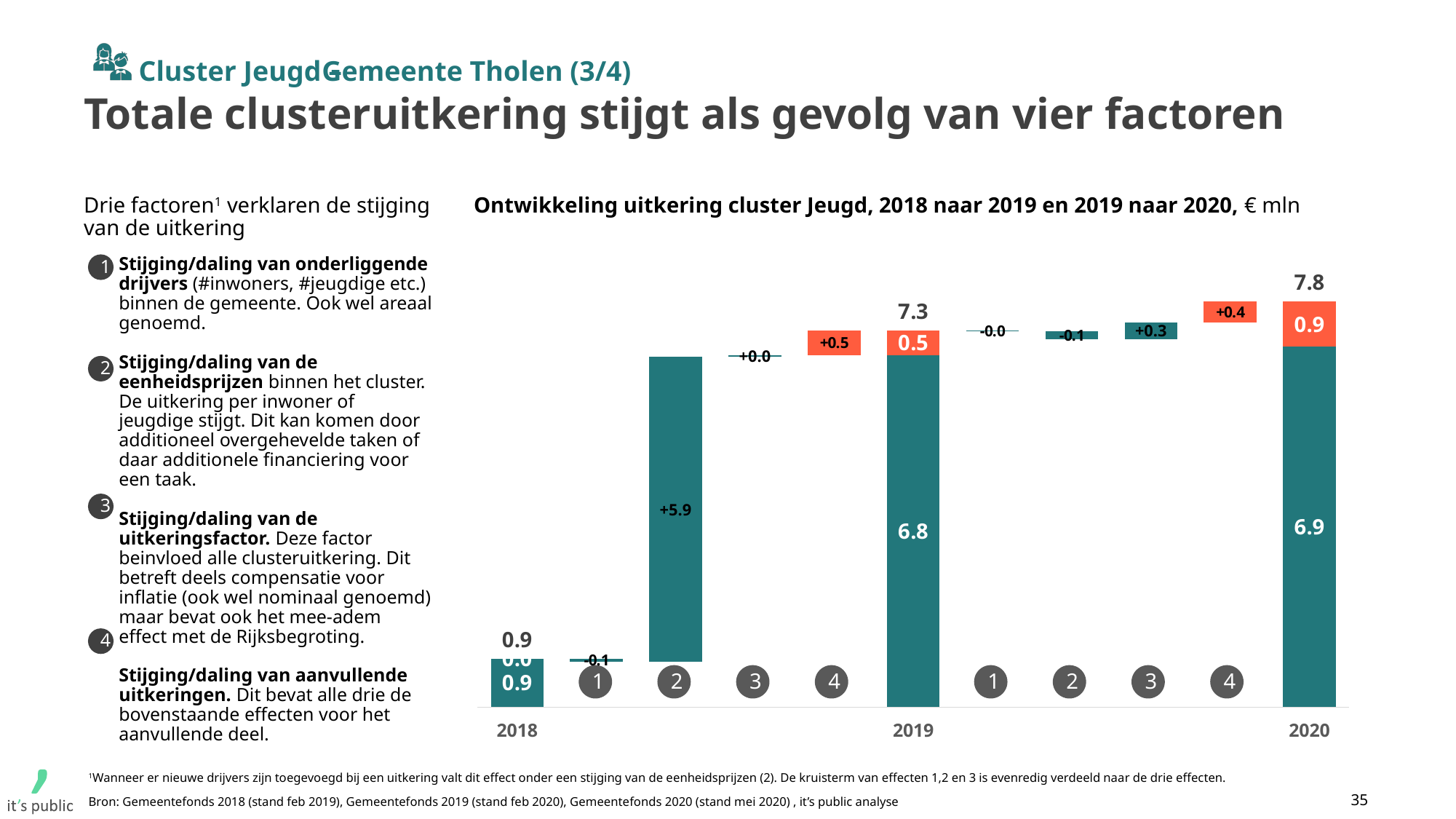
What kind of chart is shown on the slide? Bar chart (waterfall) What is the effect of factor 1 on the change from 2018 to 2019? -0.1 Which of the four factors has the largest effect on the change from 2018 to 2019? 2 What is the total uitkering for cluster Jeugd in 2019 according to the chart? 7.3 What is the effect of factor 2 on the change from 2018 to 2019? +5.9 Do the year totals rise or fall from 2018 to 2020? Rise What is the teal (lower) segment value of the 2020 bar? 6.9 Which is larger: the effect of factor 3 or factor 4 on the change from 2019 to 2020? Factor 4 What is the difference between the 2019 total (7.3) and the 2018 total (0.9)? 6.4 What is the total uitkering for cluster Jeugd in 2018 according to the chart? 0.9 What is the total uitkering for cluster Jeugd in 2020 according to the chart? 7.8 What is the effect of factor 4 on the change from 2019 to 2020? +0.4